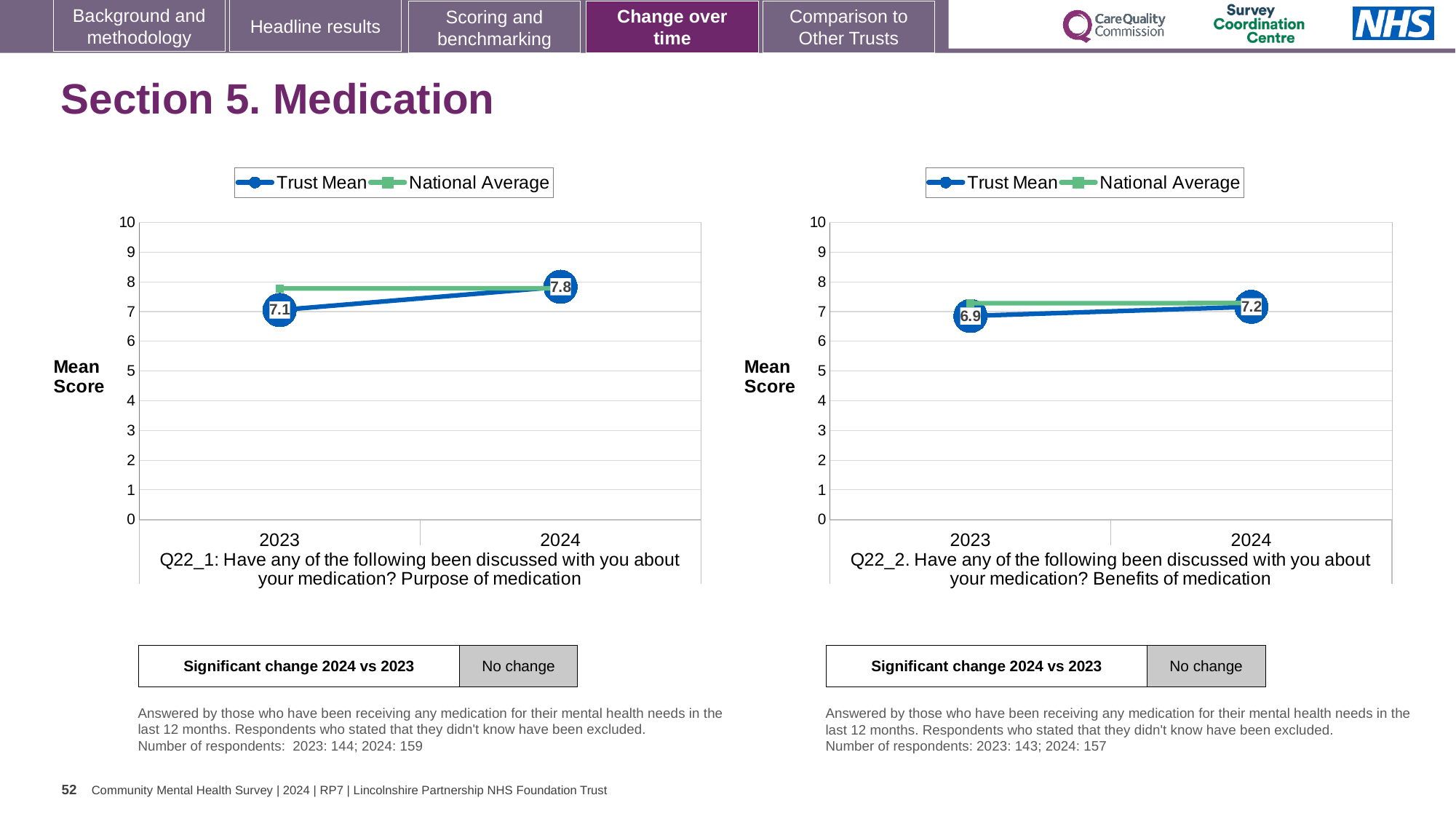
How many series does the legend list in the Q22_2 Benefits of medication chart? 2 How many years are plotted on the x axis of the Q22_1 Purpose of medication chart? 2 In the Q22_2 Benefits of medication chart, which year has the higher Trust Mean, 2023 or 2024? 2024 In the Q22_1 Purpose of medication chart, what is the Trust Mean for 2023? 7.1 In the Q22_2 Benefits of medication chart, what is the Trust Mean for 2023? 6.9 In the Q22_1 Purpose of medication chart, does the Trust Mean rise or fall from 2023 to 2024? rise In the Q22_2 Benefits of medication chart, what is the difference between the Trust Mean in 2024 and 2023? 0.3 What type of chart is used for Q22_1 Purpose of medication? line chart In the Q22_2 Benefits of medication chart, is the National Average for 2023 greater or less than 5? greater In the Q22_2 Benefits of medication chart, what is the Trust Mean for 2024? 7.2 In the Q22_1 Purpose of medication chart, by how much did the Trust Mean change from 2023 to 2024? 0.7 In the Q22_1 Purpose of medication chart, what is the Trust Mean for 2024? 7.8